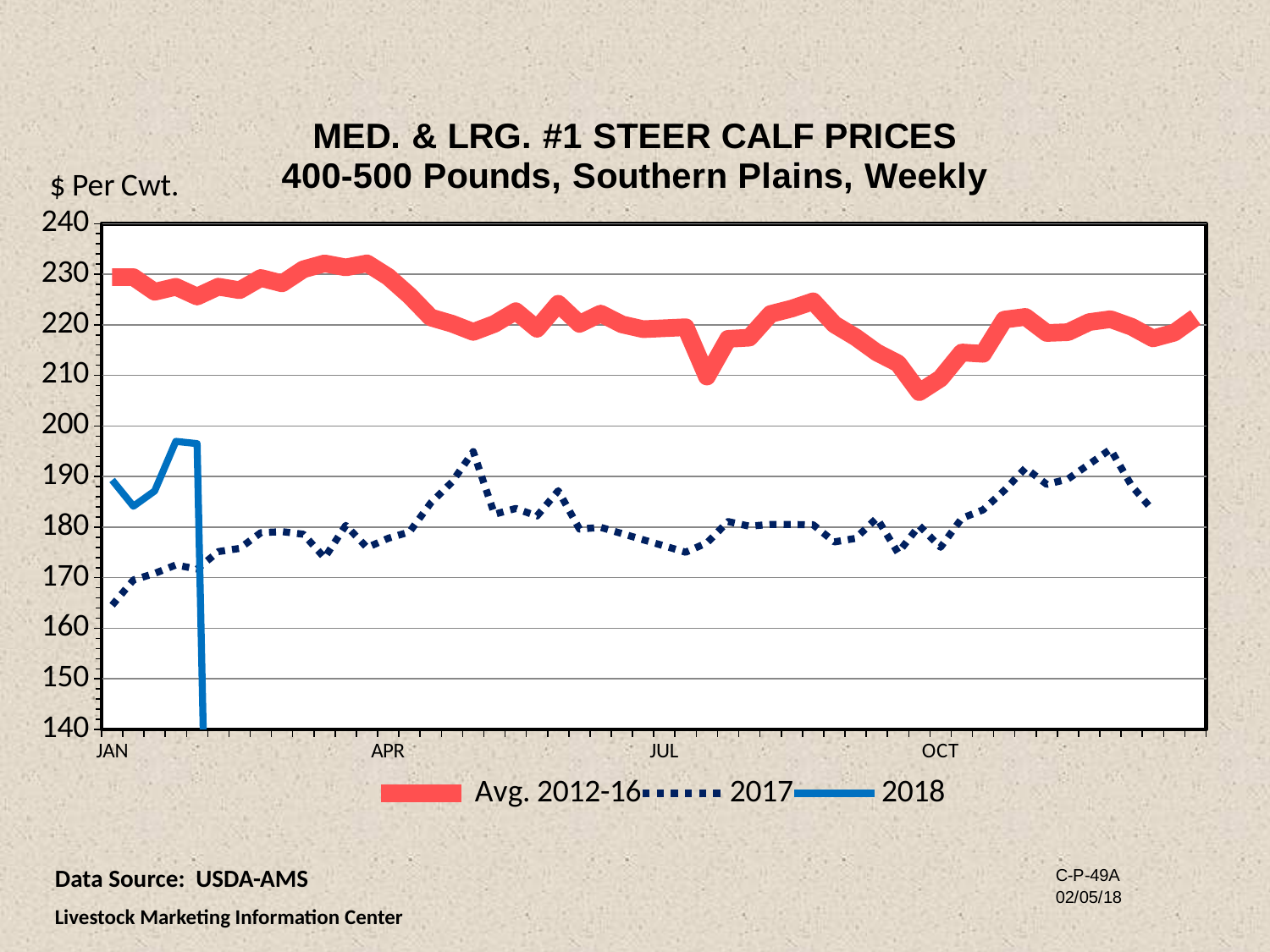
What is the label on the y axis? $ Per Cwt. Is the 2017 value in early January greater or less than 170? less Is the Avg. 2012-16 value in early January greater or less than 220? greater How many series does the legend list? 3 Is the first 2018 value in January greater or less than 180? greater How many month labels are shown on the x axis? 4 Does the 2017 line rise or fall from January to April? rise In January, which is higher, the 2018 line or the 2017 line? 2018 Which series is plotted highest on the chart across the year? Avg. 2012-16 Which series is plotted lowest at the start of January? 2017 What kind of chart is shown on the slide? line chart